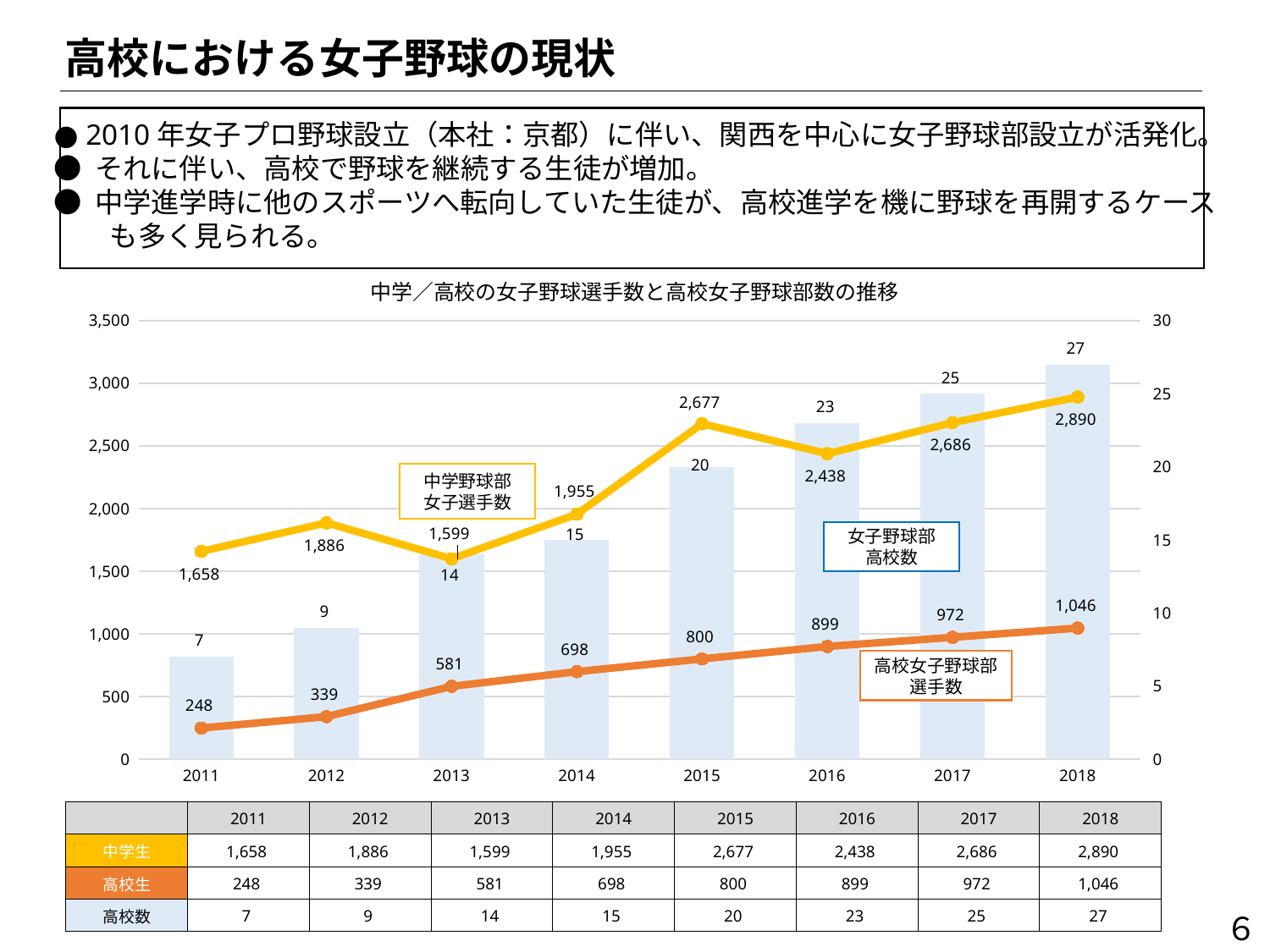
In which year is 女子野球部高校数 the highest? 2018 What is the title of the chart? 中学／高校の女子野球選手数と高校女子野球部数の推移 What is the difference between 中学野球部女子選手数 in 2018 and in 2017? 204 Which is larger in 2016: 中学野球部女子選手数 or 高校女子野球部選手数? 中学野球部女子選手数 Does 高校女子野球部選手数 rise or fall from 2011 to 2018? rise What is the maximum value shown on the right-hand axis of the chart? 30 What is the value of 高校女子野球部選手数 in 2018? 1,046 What is the difference between 高校女子野球部選手数 in 2016 and in 2015? 99 What is the value of 中学野球部女子選手数 in 2015? 2,677 How many years are shown on the x axis of the chart? 8 In which year is 中学野球部女子選手数 the lowest? 2013 How many 女子野球部高校数 are shown for 2013? 14